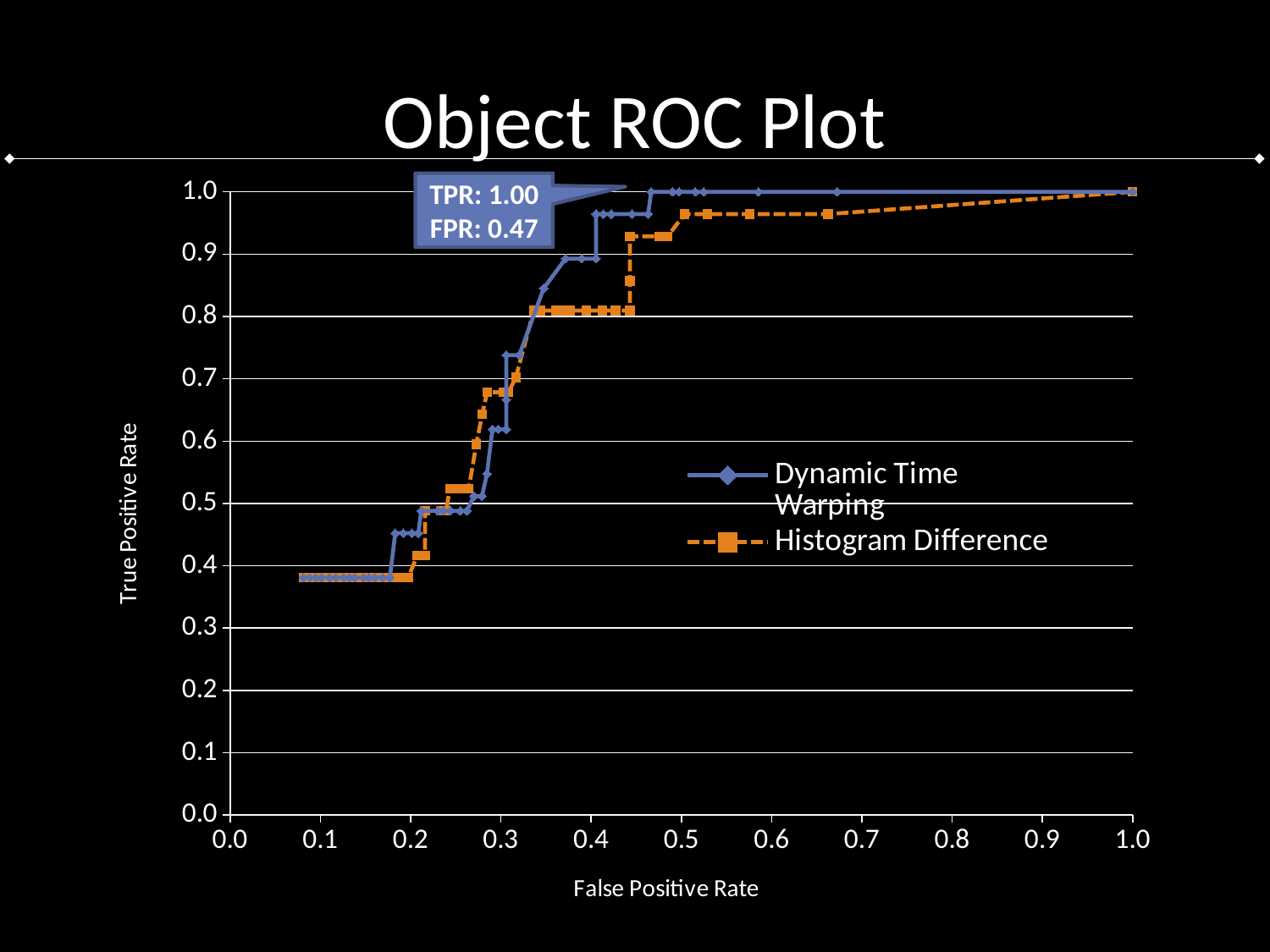
At a False Positive Rate of 0.4, which series has the higher True Positive Rate, Dynamic Time Warping or Histogram Difference? Dynamic Time Warping Does the True Positive Rate rise or fall as the False Positive Rate increases along the x axis? rise How many series does the legend list? 2 Is the True Positive Rate of the Dynamic Time Warping series at a False Positive Rate of 0.1 greater or less than 0.5? less Is the True Positive Rate of the Histogram Difference series at a False Positive Rate of 0.6 greater or less than 0.9? greater Is the True Positive Rate of the Histogram Difference series at a False Positive Rate of 0.4 greater or less than 0.9? less According to the callout on the chart, at what False Positive Rate does the Dynamic Time Warping curve reach a True Positive Rate of 1.00? 0.47 What kind of chart is shown on the slide? line chart Which series reaches a True Positive Rate of 1.0 at a lower False Positive Rate, Dynamic Time Warping or Histogram Difference? Dynamic Time Warping What is the title of the chart? Object ROC Plot What TPR value is shown in the callout label on the chart? 1.00 What are the two series named in the legend? Dynamic Time Warping and Histogram Difference